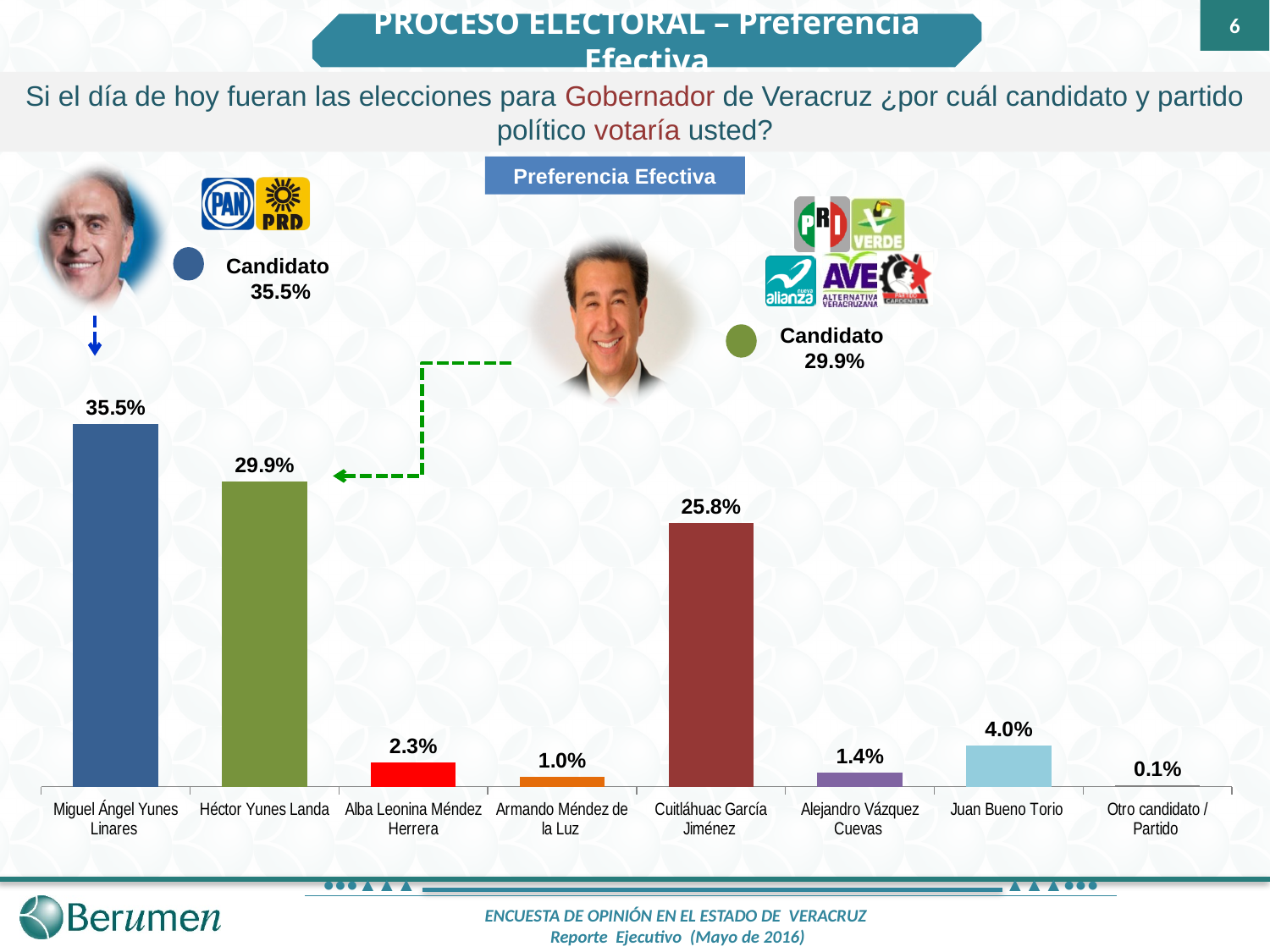
What is the value for Cuitláhuac García Jiménez? 25.8% What is the value for Juan Bueno Torio? 4.0% Which is larger, the value for Alba Leonina Méndez Herrera or the value for Alejandro Vázquez Cuevas? Alba Leonina Méndez Herrera How many categories are shown on the x axis? 8 What is the value for Armando Méndez de la Luz? 1.0% Which category has the lowest value? Otro candidato / Partido What kind of chart is shown on the slide? bar chart What is the difference between the values for Miguel Ángel Yunes Linares and Héctor Yunes Landa? 5.6% What is the difference between the values for Héctor Yunes Landa and Cuitláhuac García Jiménez? 4.1% What is the value for Miguel Ángel Yunes Linares? 35.5% What is the title shown in the box above the chart? Preferencia Efectiva Which category has the highest value? Miguel Ángel Yunes Linares